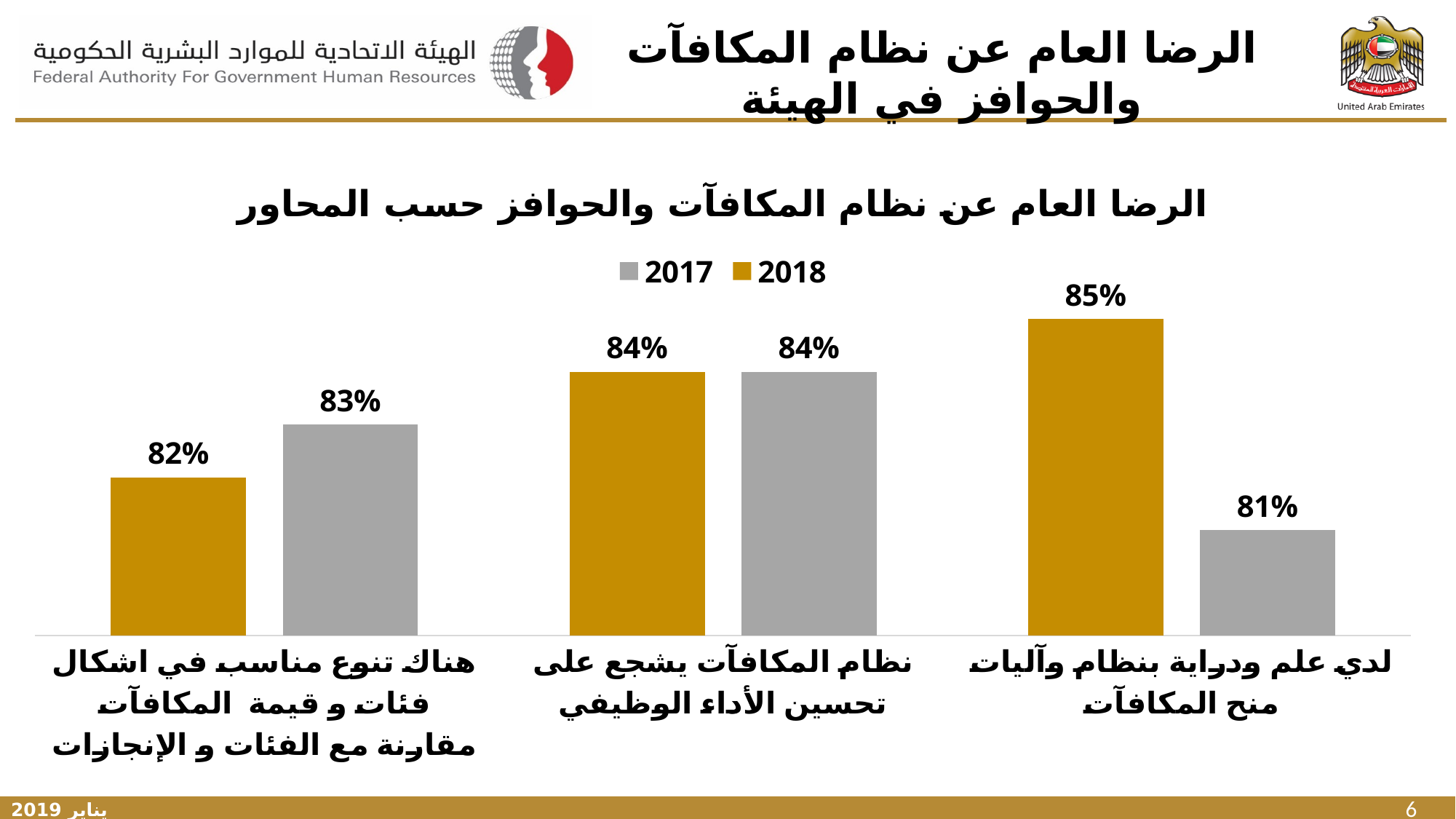
What is the 2018 value for "لدي علم ودراية بنظام وآليات منح المكافآت"? 85% Which category has the highest 2018 value? لدي علم ودراية بنظام وآليات منح المكافآت What is the 2017 value for "لدي علم ودراية بنظام وآليات منح المكافآت"? 81% What is the 2017 value for "هناك تنوع مناسب في اشكال فئات و قيمة المكافآت مقارنة مع الفئات و الإنجازات"? 83% What is the difference between the 2018 and 2017 values for "لدي علم ودراية بنظام وآليات منح المكافآت"? 4% How many series does the chart legend list? 2 What is the 2018 value for "نظام المكافآت يشجع على تحسين الأداء الوظيفي"? 84% For "هناك تنوع مناسب في اشكال فئات و قيمة المكافآت مقارنة مع الفئات و الإنجازات", which year has the larger value, 2017 or 2018? 2017 How many categories are shown on the x axis of the chart? 3 Which category has the lowest 2017 value? لدي علم ودراية بنظام وآليات منح المكافآت What type of chart is shown on the slide? Bar chart Which colour represents the 2018 series in the chart? Gold